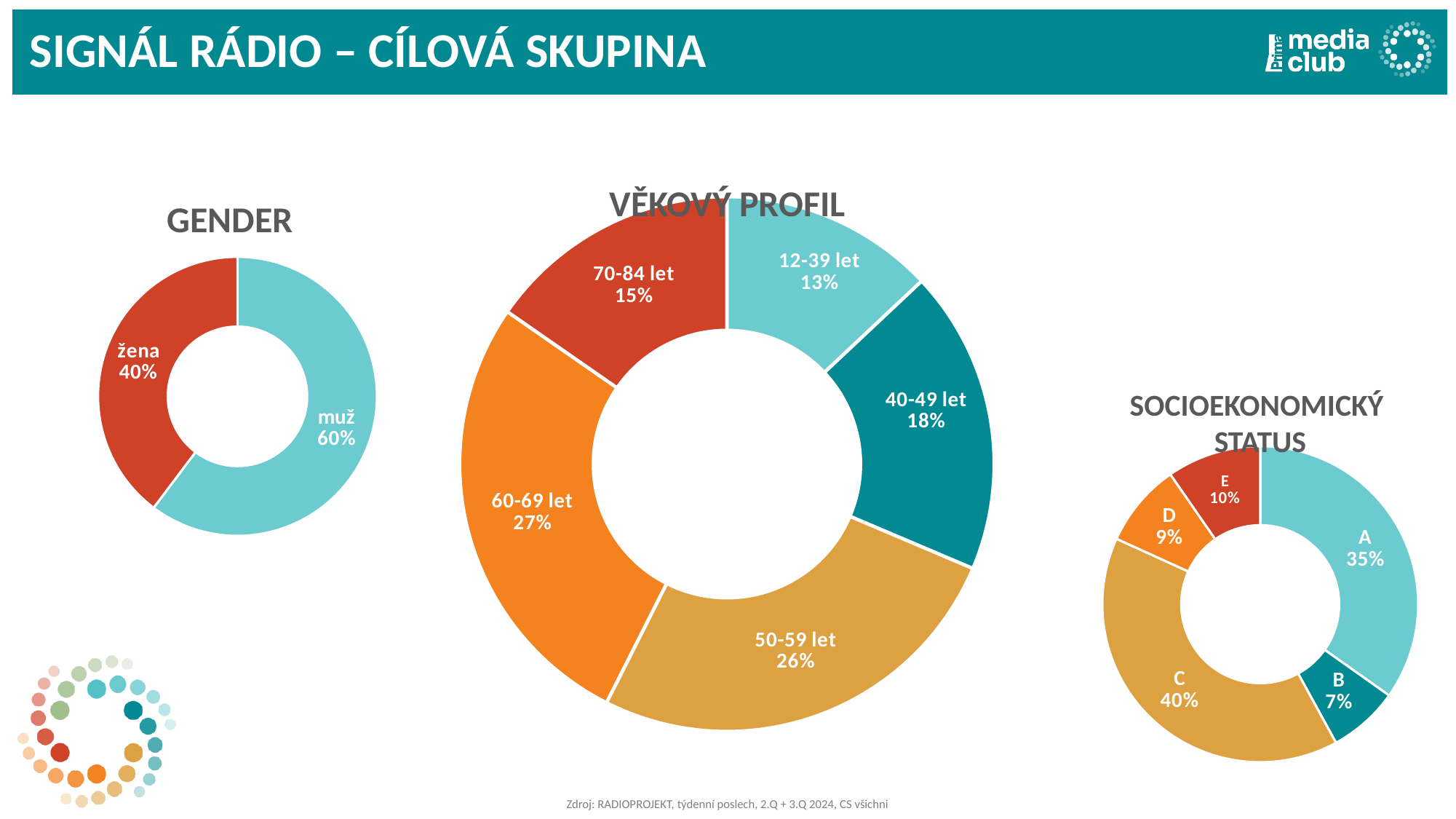
In the GENDER chart, what is the share for žena? 40% In the VĚKOVÝ PROFIL chart, which age group has the largest share? 60-69 let In the SOCIOEKONOMICKÝ STATUS chart, which category has the smallest share? B What kind of chart is the GENDER chart? Doughnut (pie) chart In the VĚKOVÝ PROFIL chart, what is the share for 40-49 let? 18% In the VĚKOVÝ PROFIL chart, which age group has the smallest share? 12-39 let In the SOCIOEKONOMICKÝ STATUS chart, what is the share for category C? 40% In the VĚKOVÝ PROFIL chart, what is the difference between the shares for 50-59 let and 70-84 let? 11% In the VĚKOVÝ PROFIL chart, how many age groups are shown? 5 In the SOCIOEKONOMICKÝ STATUS chart, which is larger, the share for D or the share for E? E In the GENDER chart, what is the share for muž? 60% In the VĚKOVÝ PROFIL chart, what is the share for 60-69 let? 27%